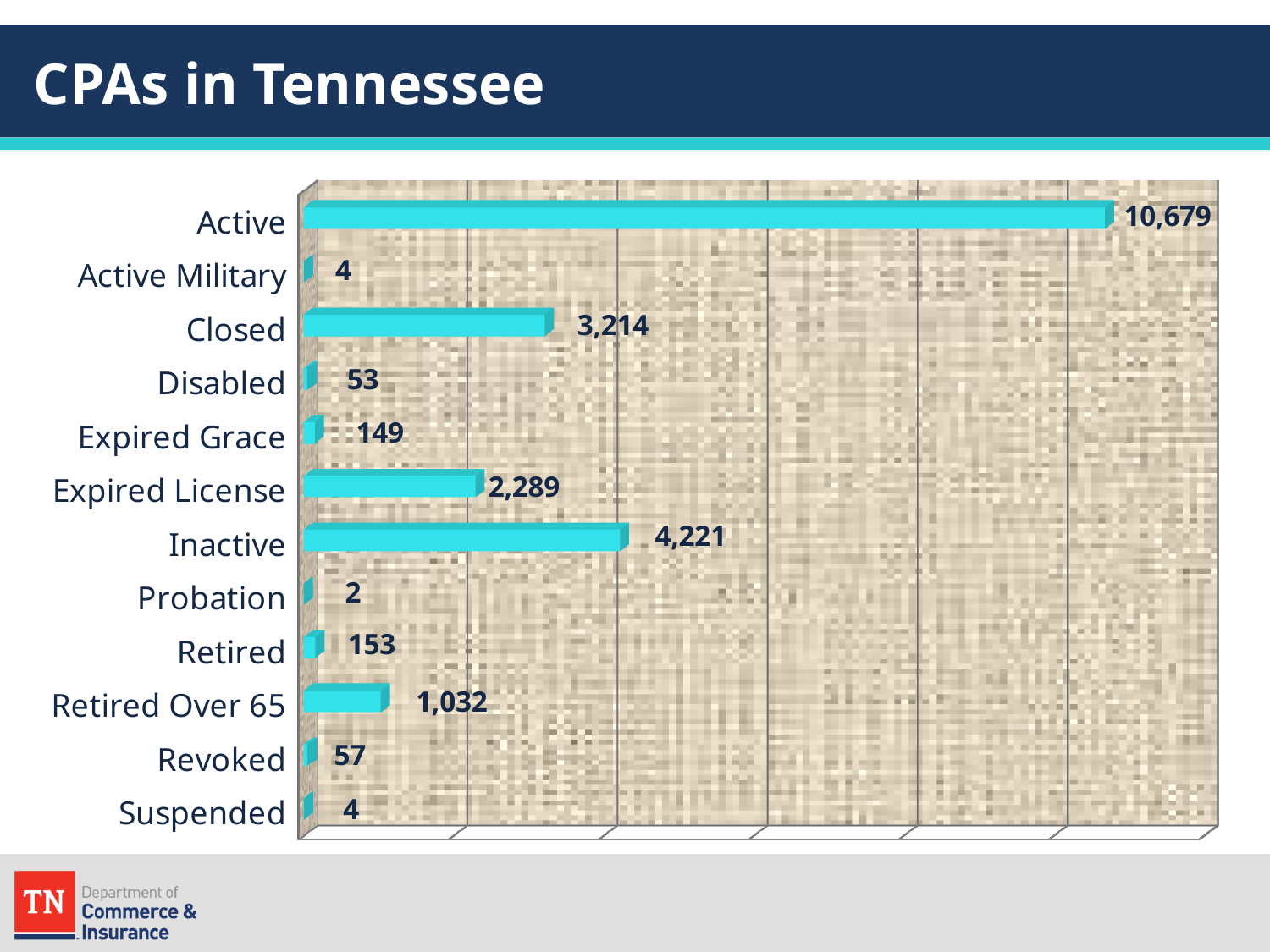
What is the difference between the values for Retired and Expired Grace? 4 Which is larger, the value for Closed or the value for Expired License? Closed What is the value for Inactive? 4,221 Which category has the highest value? Active What is the value for Expired Grace? 149 What is the title of the slide? CPAs in Tennessee Which category has the lowest value? Probation What is the value for Retired Over 65? 1,032 How many categories are shown in the chart? 12 What is the value for Active? 10,679 What kind of chart is shown on the slide? Bar chart What is the difference between the values for Inactive and Closed? 1,007